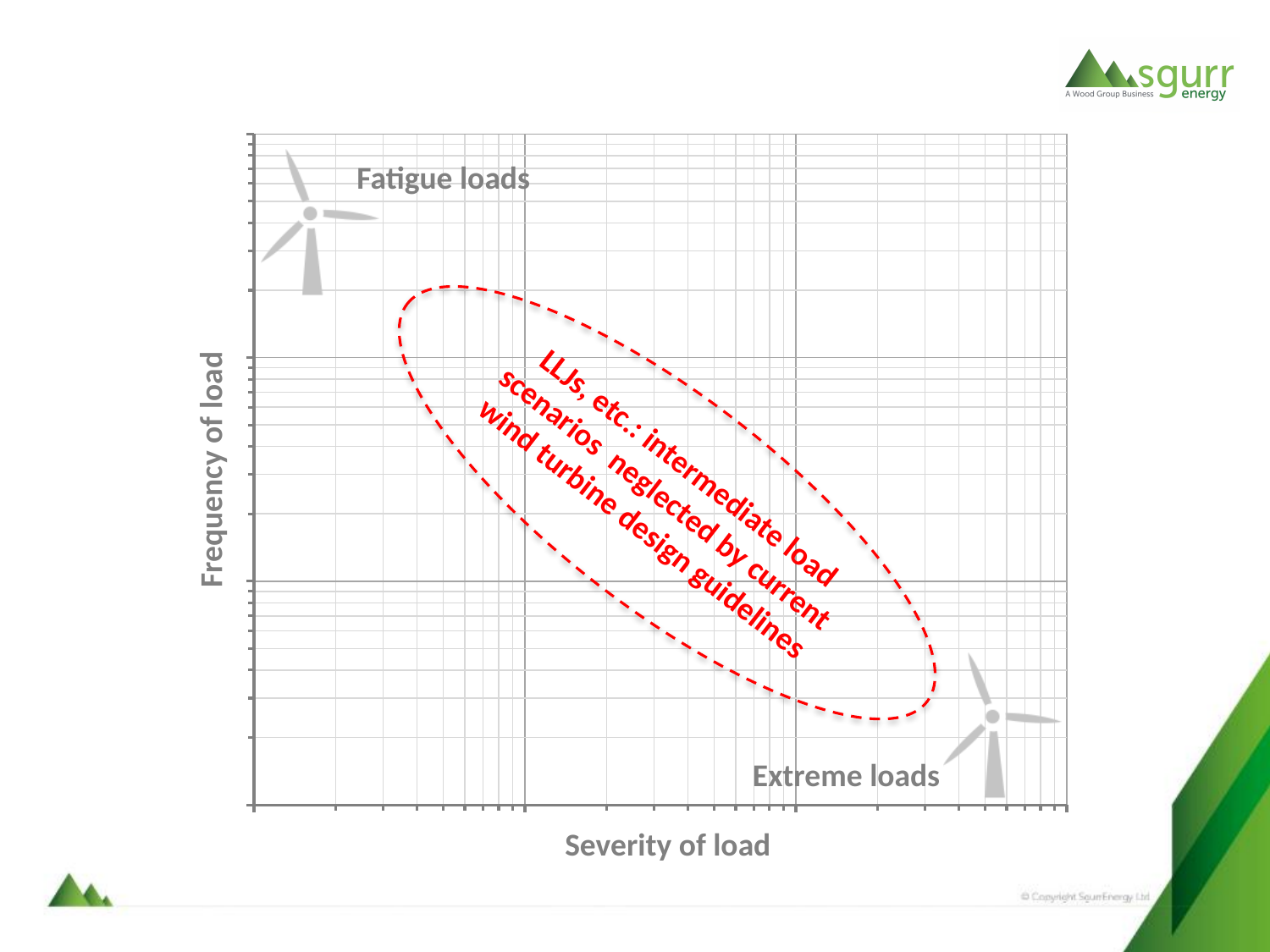
What is the title of the y axis of the chart? Frequency of load What is the title of the x axis of the chart? Severity of load According to the chart, as severity of load increases along the x axis, does frequency of load rise or fall? fall